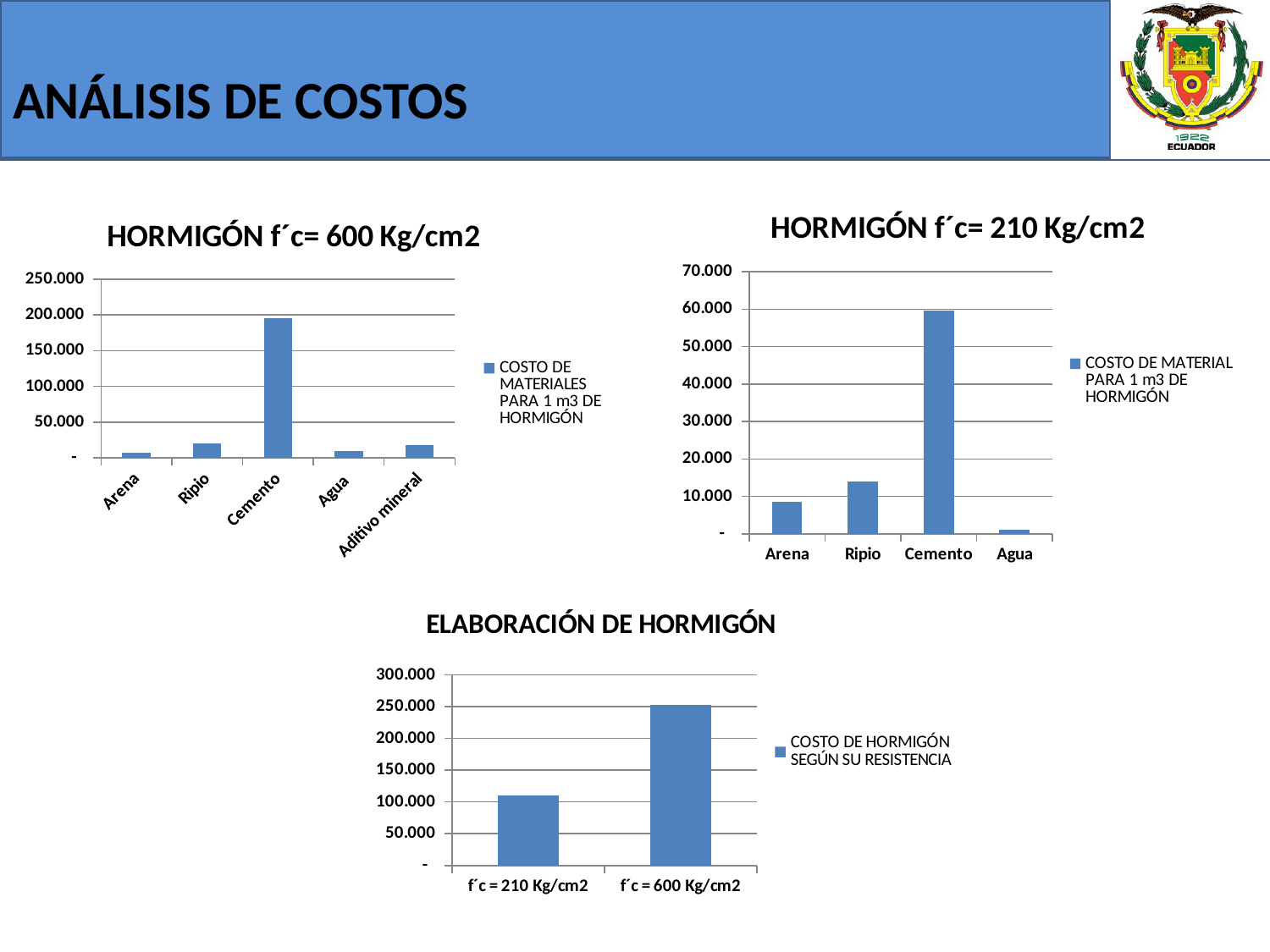
In the chart titled HORMIGÓN f´c= 600 Kg/cm2, is the value for Cemento greater or less than 150.000? greater What kind of chart is the chart titled ELABORACIÓN DE HORMIGÓN? Bar chart In the chart titled ELABORACIÓN DE HORMIGÓN, is the value for f´c = 210 Kg/cm2 greater or less than 150.000? less In the chart titled HORMIGÓN f´c= 210 Kg/cm2, how many categories are shown on the x axis? 4 In the chart titled HORMIGÓN f´c= 210 Kg/cm2, which is larger, the value for Ripio or the value for Arena? Ripio In the chart titled HORMIGÓN f´c= 600 Kg/cm2, which category has the highest cost? Cemento In the chart titled ELABORACIÓN DE HORMIGÓN, what is the legend entry for the series? COSTO DE HORMIGÓN SEGÚN SU RESISTENCIA In the chart titled ELABORACIÓN DE HORMIGÓN, which category has the higher cost? f´c = 600 Kg/cm2 In the chart titled HORMIGÓN f´c= 600 Kg/cm2, is the value for Ripio greater or less than 50.000? less In the chart titled HORMIGÓN f´c= 600 Kg/cm2, how many categories are shown on the x axis? 5 In the chart titled HORMIGÓN f´c= 210 Kg/cm2, which category has the lowest cost? Agua